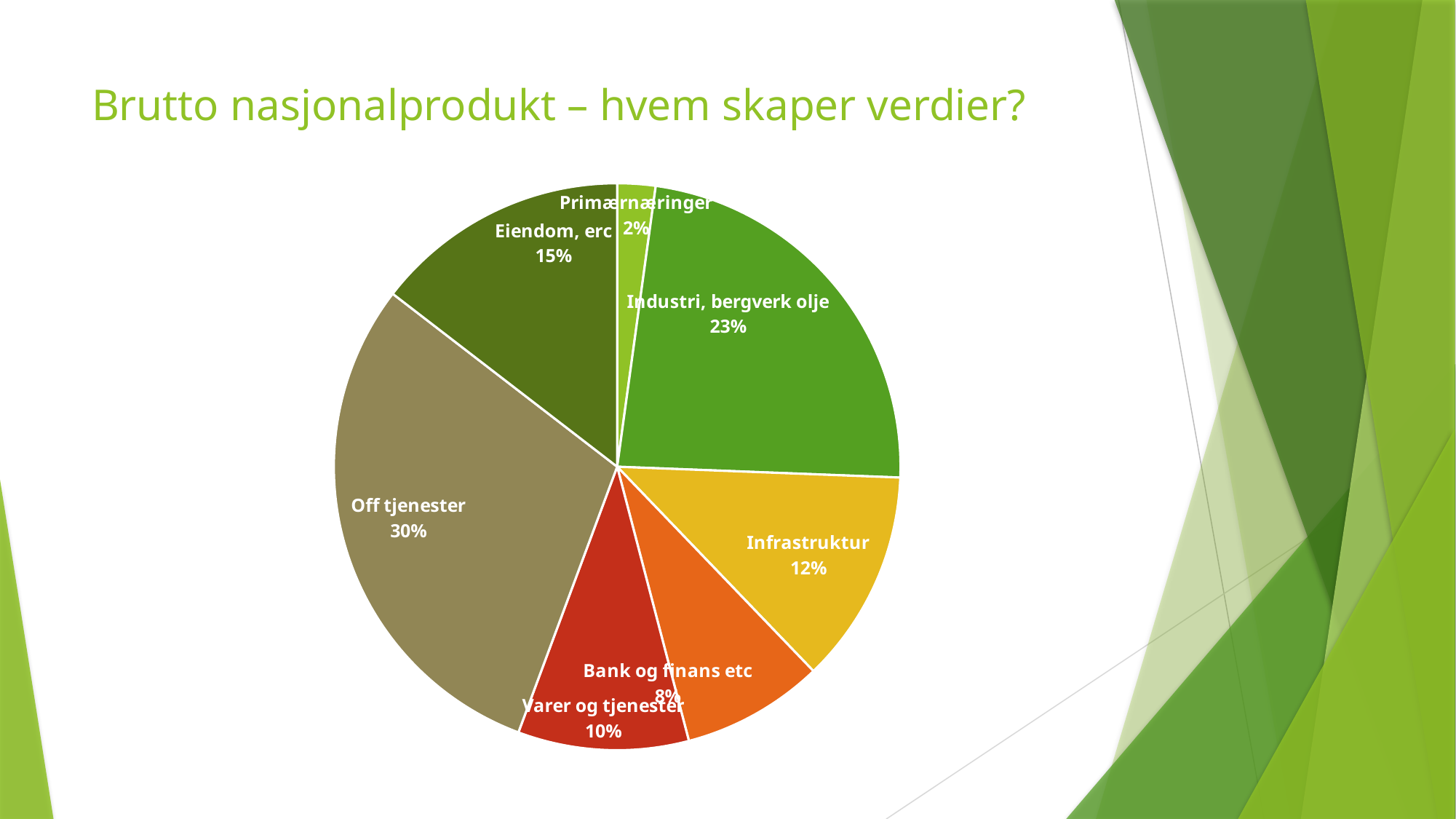
Which category has the smallest slice of the pie? Primærnæringer What kind of chart is shown on the slide? pie chart What is the difference in percentage points between Off tjenester and Industri, bergverk olje? 7 What percentage is shown for Primærnæringer? 2% What is the value shown for Industri, bergverk olje? 23% How many slices does the pie chart have? 7 Which category has the largest slice of the pie? Off tjenester What is the value for Eiendom, erc? 15% What share of the pie does Off tjenester have? 30% Which is larger, Varer og tjenester or Bank og finans etc? Varer og tjenester What percentage is shown for Infrastruktur? 12% What is the title of the slide containing the pie chart? Brutto nasjonalprodukt – hvem skaper verdier?